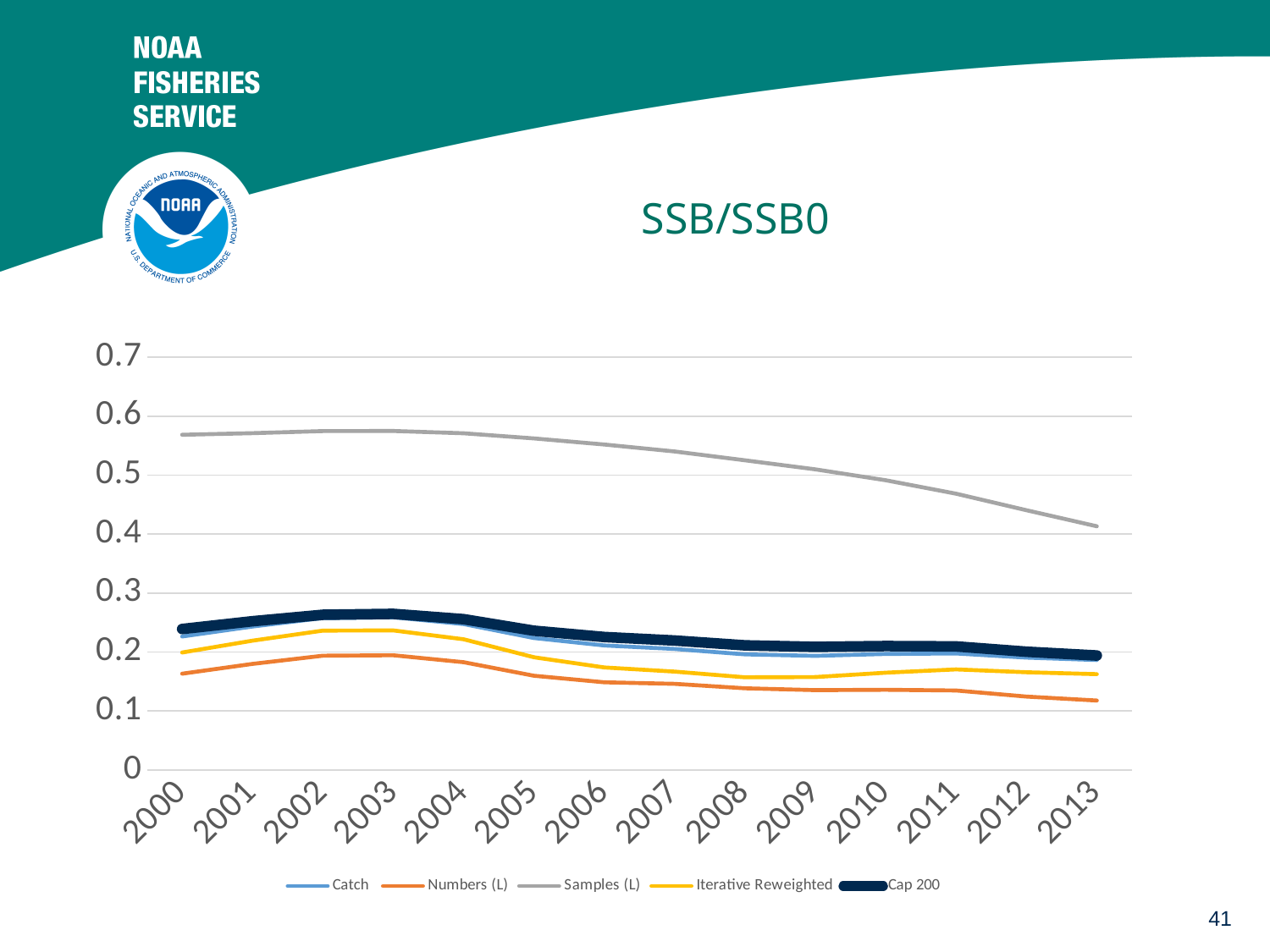
Is the value for Samples (L) in 2010 greater or less than 0.6? less Is the value for Numbers (L) in 2013 greater or less than 0.2? less Is the value for Cap 200 in 2003 greater or less than 0.2? greater What is the title of the chart? SSB/SSB0 How many series does the legend list? 5 Which is larger in 2008, Cap 200 or Numbers (L)? Cap 200 Which series has the highest values across all years? Samples (L) How many years are shown along the x axis? 14 Does the Samples (L) series rise or fall from 2003 to 2013? fall What type of chart is shown on the slide? line chart Which series has the lowest values across all years? Numbers (L)